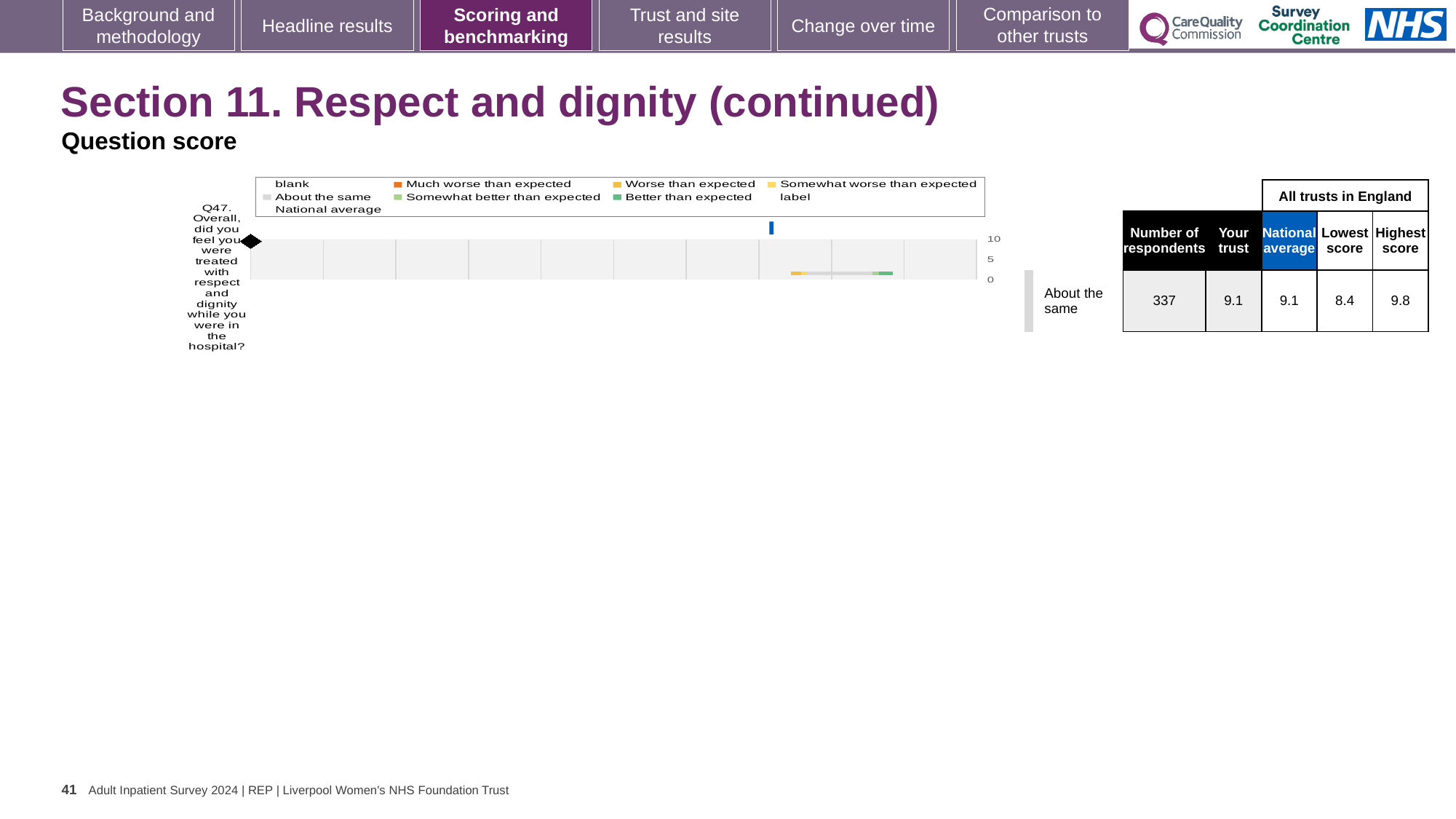
What is the highest tick value shown on the chart's value axis? 10 How many question categories are plotted on the chart? 1 What kind of chart is shown on the slide? bar chart How many entries does the chart's legend list? 9 What is the lowest tick value shown on the chart's value axis? 0 Which question number is plotted on the chart? Q47